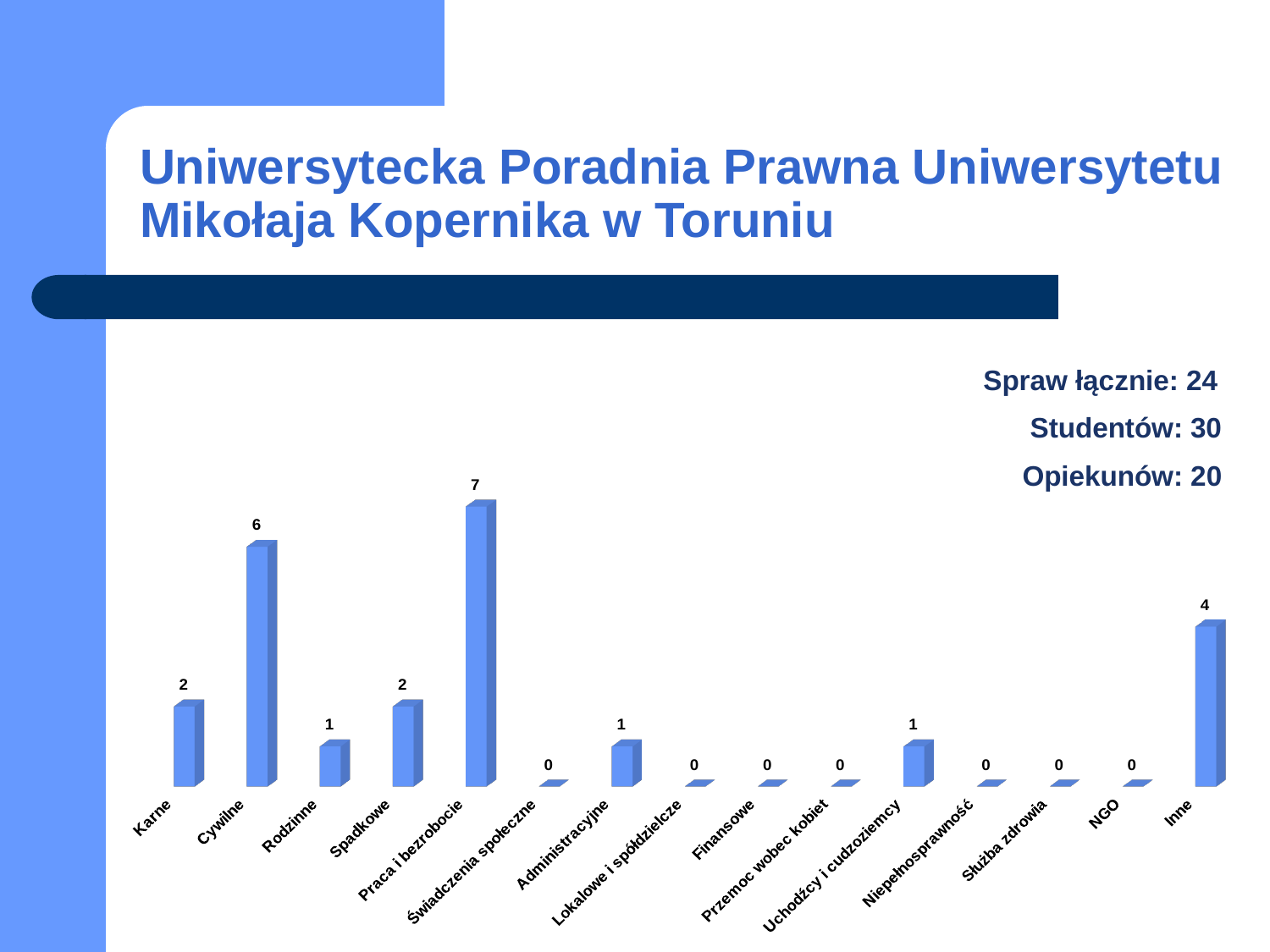
Which category has the highest value? Praca i bezrobocie What is the value for Uchodźcy i cudzoziemcy? 1 How many categories have a value of 0? 7 How many categories are shown on the x axis of the chart? 15 What kind of chart is shown on the slide? Bar chart What is the value for Cywilne? 6 What is the difference between the values for Praca i bezrobocie and Cywilne? 1 Which is larger, the value for Spadkowe or the value for Rodzinne? Spadkowe What is the value for Administracyjne? 1 What is the value for Praca i bezrobocie? 7 What is the difference between the values for Inne and Karne? 2 What is the value for Inne? 4